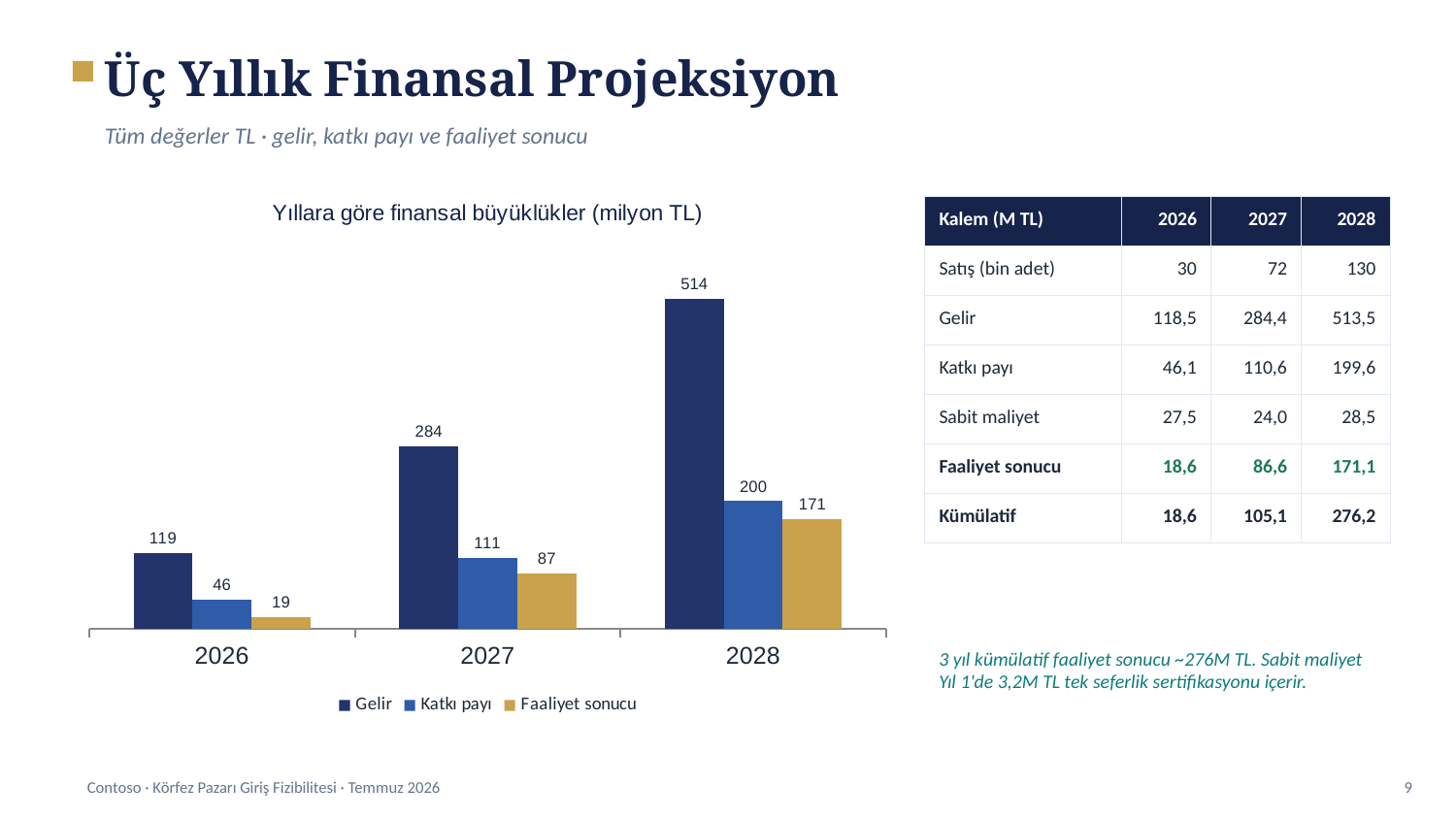
What is the value of Katkı payı for 2027 in the chart? 111 Which year has the highest Gelir value in the chart? 2028 Which is larger in the chart: Katkı payı for 2028 or Gelir for 2026? Katkı payı for 2028 What is the value of Gelir for 2028 in the chart? 514 Do the Faaliyet sonucu values rise or fall from 2026 to 2028 in the chart? Rise What is the difference between Katkı payı and Faaliyet sonucu for 2028 in the chart? 29 What is the difference between the Gelir values for 2027 and 2026 in the chart? 165 Which year has the lowest Faaliyet sonucu value in the chart? 2026 What kind of chart is shown on the slide? Bar chart What is the value of Faaliyet sonucu for 2026 in the chart? 19 How many series does the chart legend list? 3 How many years are shown on the x axis of the chart? 3